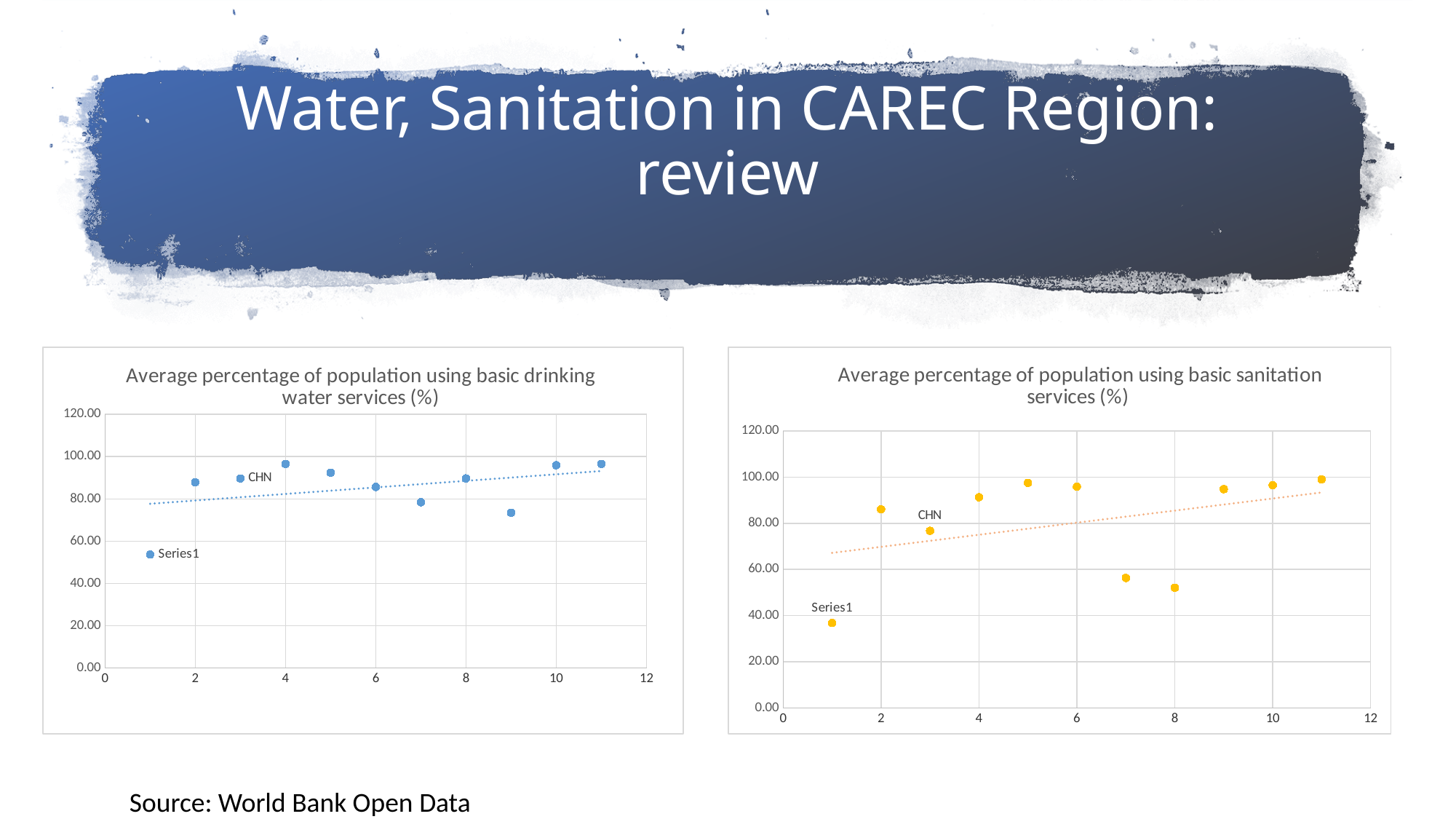
In the right chart on basic sanitation services, is the value of the point at x = 7 greater or less than 60? less In the left chart on basic drinking water services, at which x value is the lowest point plotted? 1 In the right chart on basic sanitation services, which point has the larger value: the one at x = 2 or the one at x = 8? x = 2 How many data points are plotted in the right chart, 'Average percentage of population using basic sanitation services (%)'? 11 In the left chart on basic drinking water services, is the value of the point at x = 9 greater or less than 80? less What kind of chart is the left chart, 'Average percentage of population using basic drinking water services (%)'? scatter chart In the right chart on basic sanitation services, at which x value is the lowest point plotted? 1 What kind of chart is the right chart, 'Average percentage of population using basic sanitation services (%)'? scatter chart In the left chart on basic drinking water services, does the dotted trend line rise or fall from left to right? rises What is the title of the right chart? Average percentage of population using basic sanitation services (%) In the left chart on basic drinking water services, is the value of the point labelled CHN greater or less than 80? greater How many data points are plotted in the left chart, 'Average percentage of population using basic drinking water services (%)'? 11